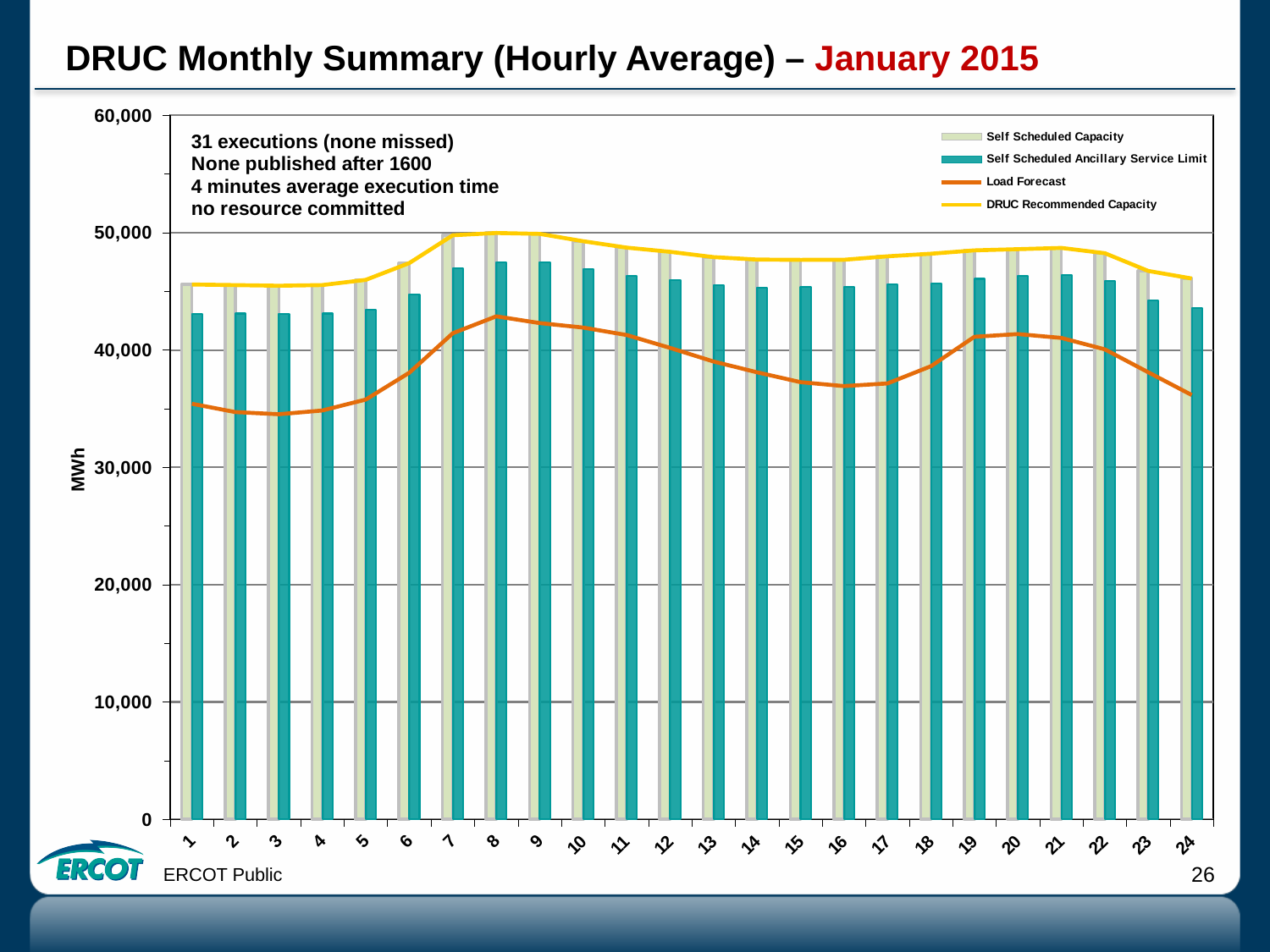
What kind of chart is shown on the slide? Combined bar and line chart Is the Load Forecast value at hour 8 greater or less than 40,000? greater Does the Load Forecast rise or fall from hour 20 to hour 24? Falls Which is larger, the Load Forecast at hour 8 or at hour 16? Hour 8 What unit is shown on the y axis of the chart? MWh Does the Load Forecast rise or fall from hour 3 to hour 8? Rises How many hours (categories) are shown on the x axis of the chart? 24 How many series does the chart legend list? 4 Is the Self Scheduled Capacity value at hour 1 greater or less than 50,000? less Which is larger, the Self Scheduled Capacity at hour 8 or at hour 1? Hour 8 Is the Load Forecast value at hour 1 greater or less than 40,000? less